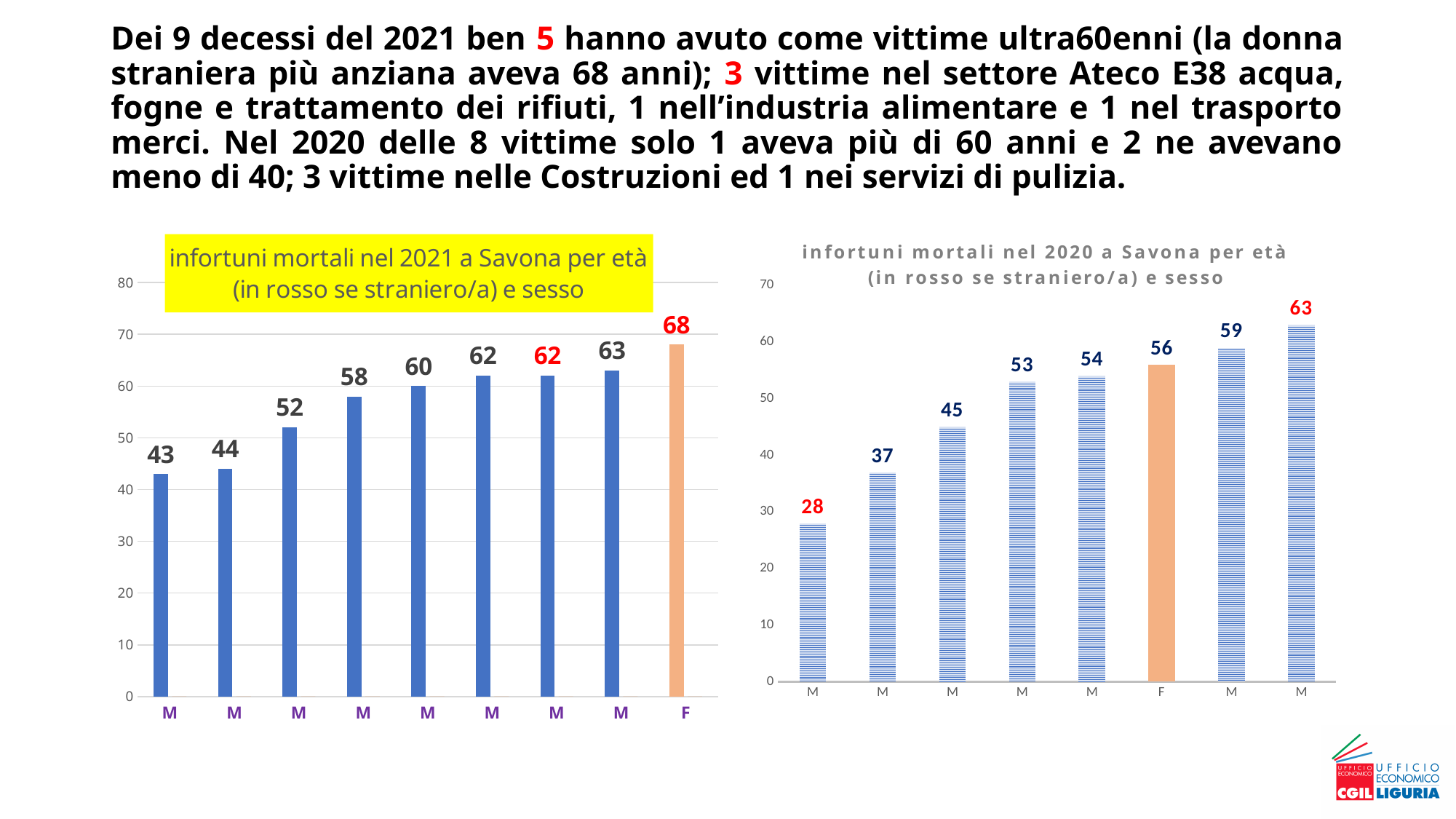
What type of chart is the 2020 chart (right)? Bar chart On the 2021 chart (left), what is the highest value shown? 68 On the 2021 chart (left), what is the difference between the highest value (68) and the lowest value (43)? 25 How many bars are on the 2021 chart (left)? 9 How many bars are on the 2020 chart (right)? 8 On the 2021 chart (left), do the values rise or fall from left to right? Rise On the 2021 chart (left), what is the value of the first bar from the left? 43 On the 2020 chart (right), what is the lowest value shown? 28 On the 2020 chart (right), what is the difference between the last bar (63) and the F bar (56)? 7 On the 2020 chart (right), what is the value of the bar for F? 56 On the 2020 chart (right), what is the value of the first bar from the left? 28 On the 2021 chart (left), what is the value of the bar for F? 68